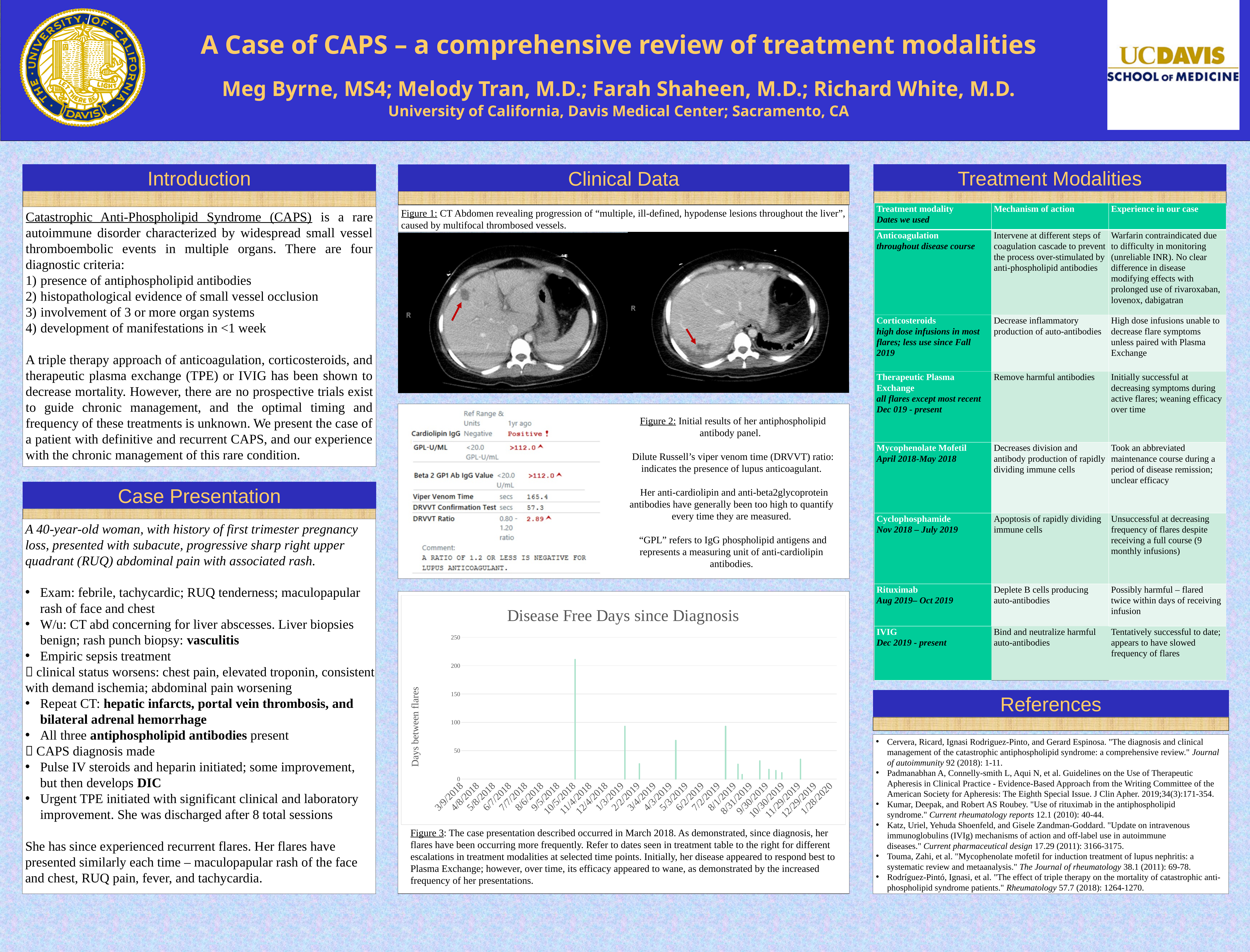
What is the highest value shown on the y axis of the "Disease Free Days since Diagnosis" chart? 250 In the "Disease Free Days since Diagnosis" chart, are all the bars after 8/1/2019 greater or less than 50? less What kind of chart is "Disease Free Days since Diagnosis"? bar chart What is the first date label on the x axis of the "Disease Free Days since Diagnosis" chart? 3/9/2018 What is the label on the y axis of the "Disease Free Days since Diagnosis" chart? Days between flares In the "Disease Free Days since Diagnosis" chart, is the tallest bar greater or less than 150? greater In the "Disease Free Days since Diagnosis" chart, is the tallest bar located in 2018 or in 2019? 2018 How many date labels are shown along the x axis of the "Disease Free Days since Diagnosis" chart? 24 In the "Disease Free Days since Diagnosis" chart, do the bar heights generally rise or fall from left to right along the x axis? fall